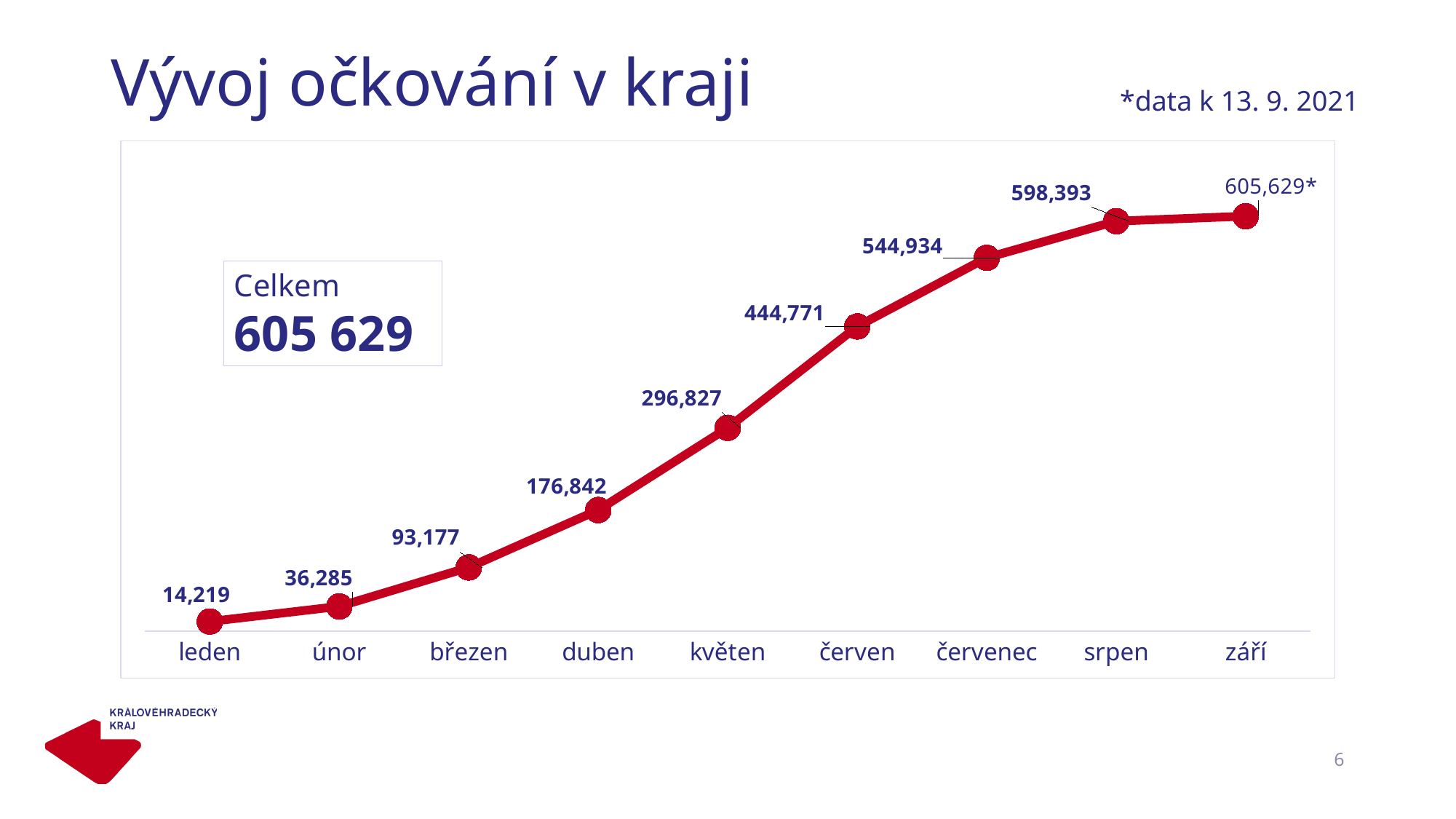
What is the value for květen? 296,827 What is the difference between the values for září and srpen? 7,236 Do the values rise or fall from leden to září? rise How many months are plotted on the chart? 9 Which month has the highest value? září Which month has the lowest value? leden What is the value for září? 605,629 What is the difference between the values for duben and březen? 83,665 What is the value for leden? 14,219 What kind of chart is shown on the slide? line chart Which is larger, the value for červen or the value for květen? červen What is the value for červenec? 544,934